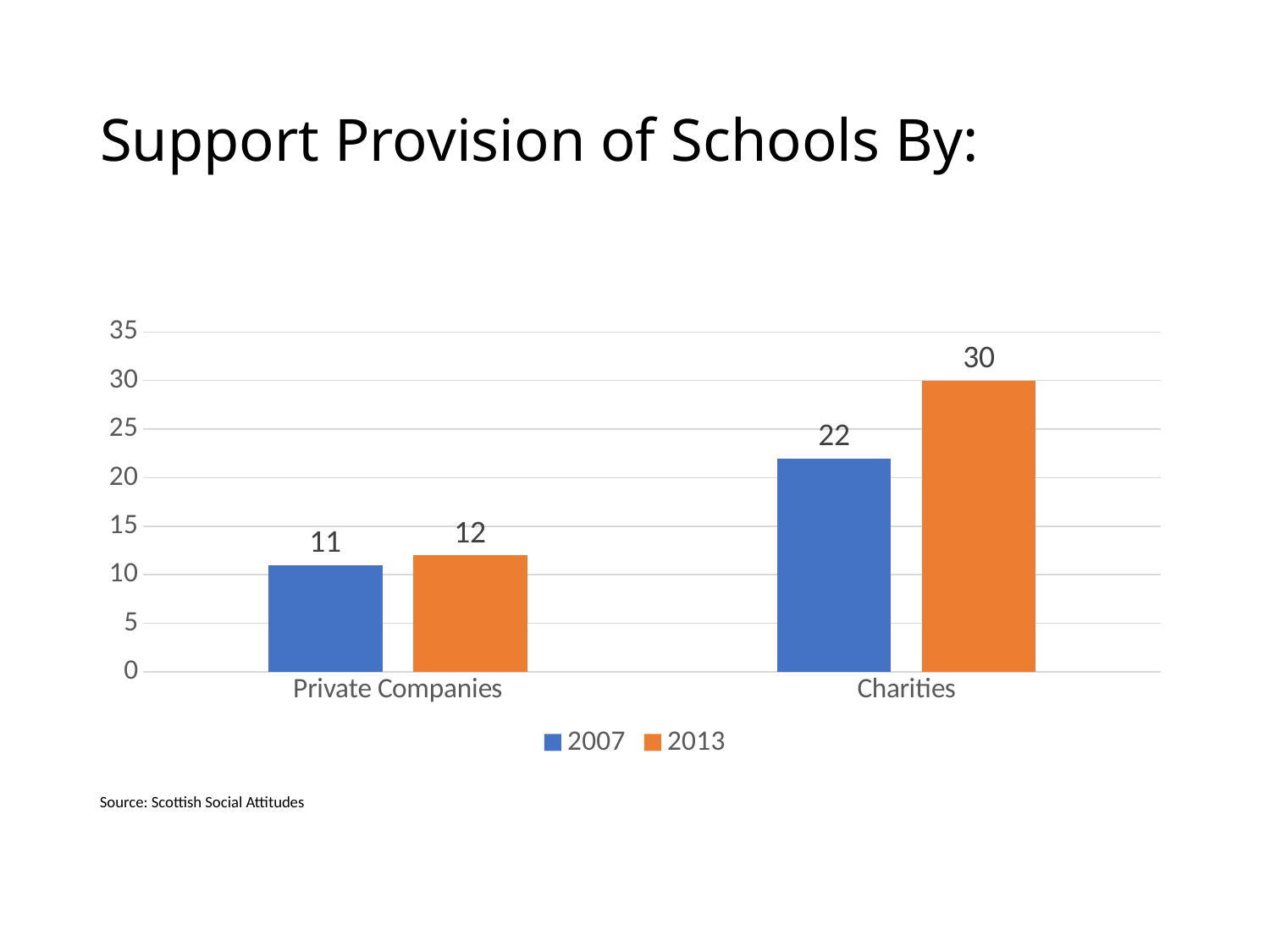
Which category has the lowest value in 2007? Private Companies What is the value for Charities in 2007? 22 What is the value for Private Companies in 2007? 11 What is the value for Charities in 2013? 30 Which is larger: the 2007 value for Charities or the 2013 value for Private Companies? 2007 value for Charities Which category has the highest value in 2013? Charities What is the value for Private Companies in 2013? 12 Is the 2013 value for Charities greater or less than 25? greater What is the difference between the 2013 and 2007 values for Charities? 8 How many series does the legend list? 2 How many categories are shown on the x axis? 2 What kind of chart is shown on the slide? bar chart